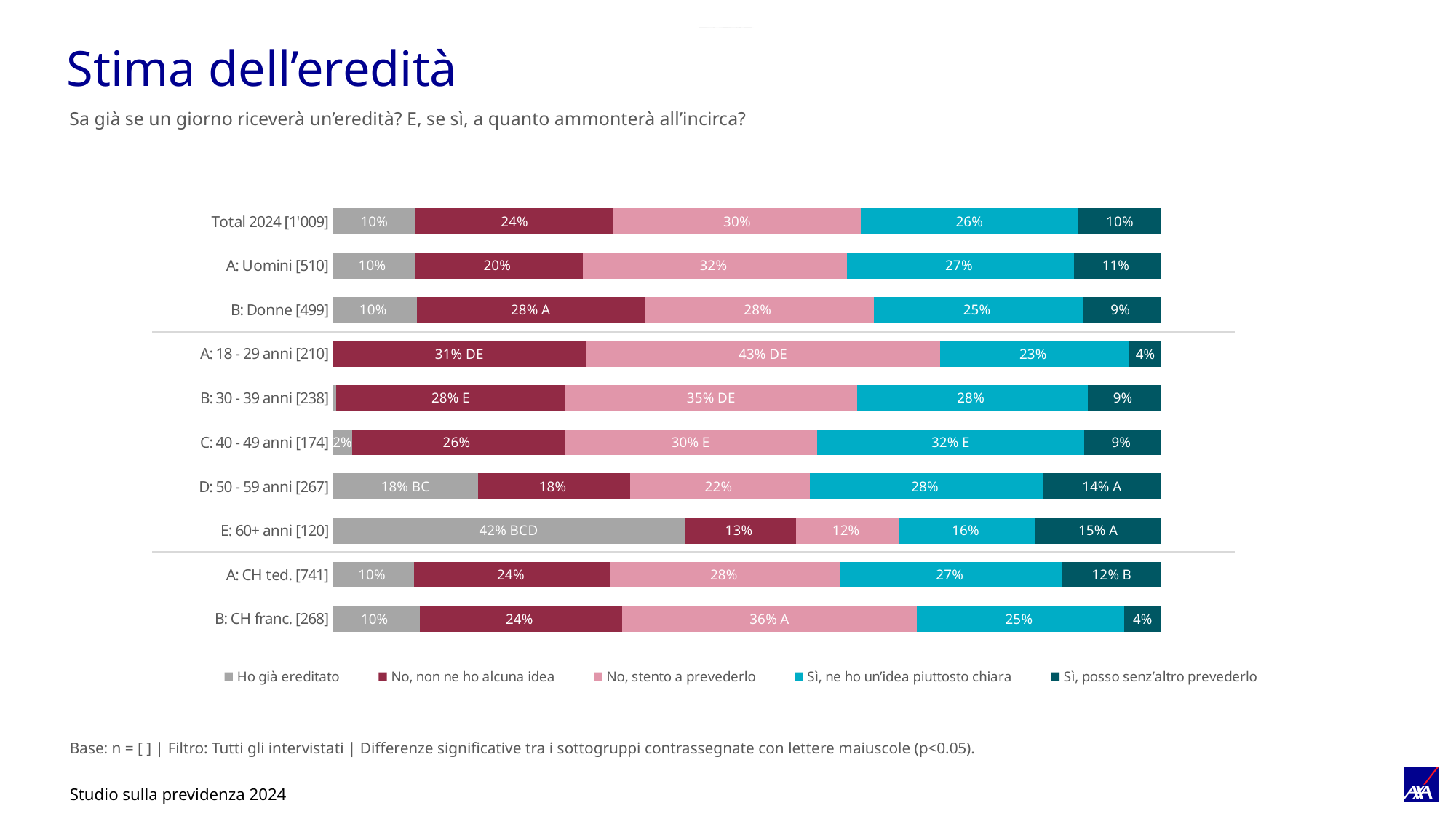
How many categories (rows) are plotted in the chart? 10 What is the total of the 'Ho già ereditato' and 'No, non ne ho alcuna idea' segments for D: 50 - 59 anni? 36% Which legend entry is shown in grey? Ho già ereditato What is the difference between the 'No, non ne ho alcuna idea' values for B: Donne and A: Uomini? 8 percentage points What is the value of 'Sì, posso senz'altro prevederlo' for B: CH franc.? 4% How many series does the legend list? 5 Which is larger: 'Sì, ne ho un'idea piuttosto chiara' for C: 40 - 49 anni or for D: 50 - 59 anni? C: 40 - 49 anni Which category has the highest value for 'No, stento a prevederlo'? A: 18 - 29 anni What type of chart is shown on the slide? Stacked bar chart What is the value of 'Ho già ereditato' for E: 60+ anni? 42% Which category has the lowest value for 'Sì, ne ho un'idea piuttosto chiara'? E: 60+ anni What is the value of 'No, stento a prevederlo' for Total 2024? 30%